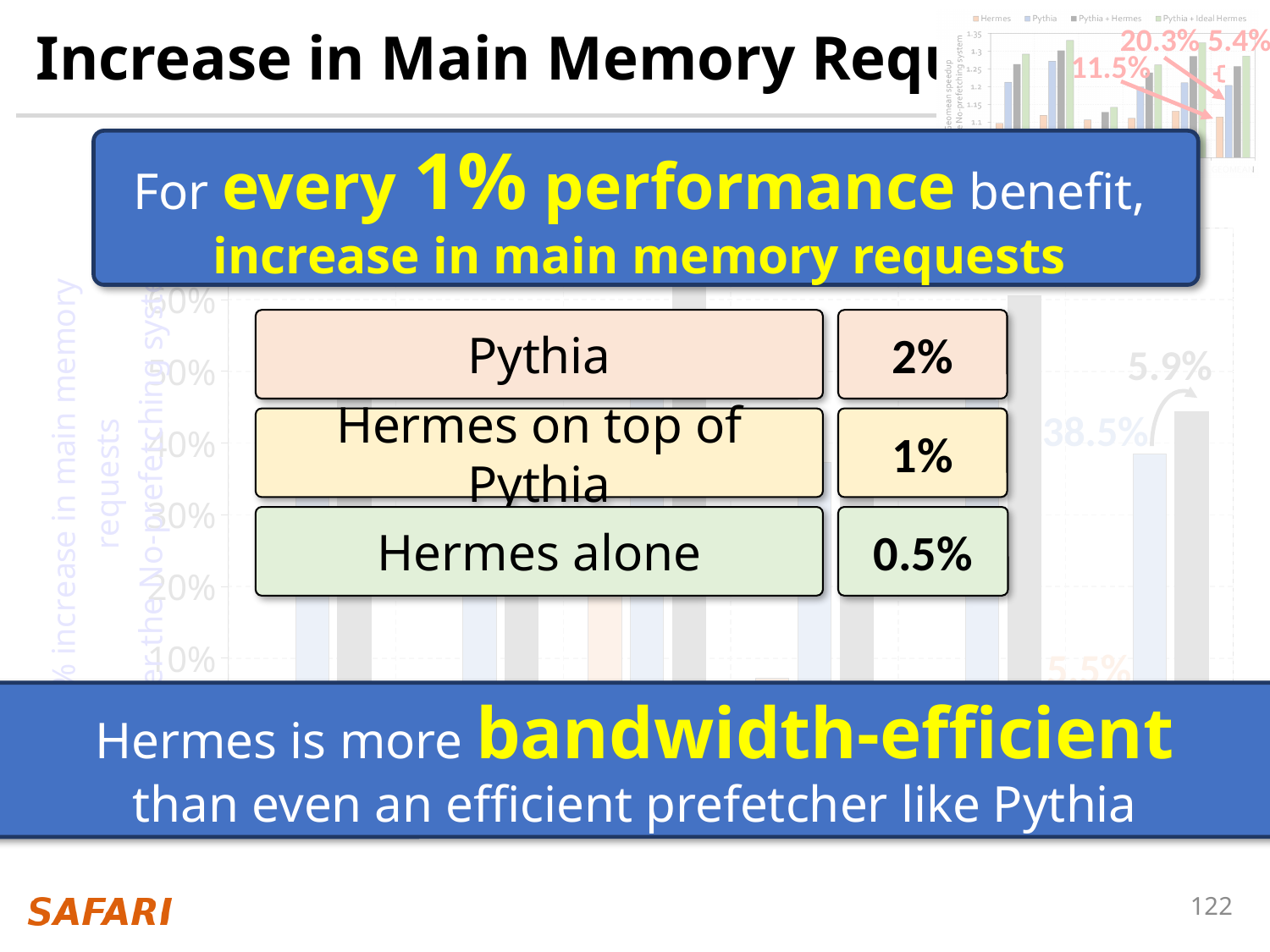
According to the boxes overlaid on the chart, what is the increase in main memory requests per 1% performance benefit for Pythia? 2% On the large background chart, what is the lowest y-axis tick label shown? 10% On the large background chart, which is larger, the value labeled 38.5% or the value labeled 5.5%? 38.5% How many series does the legend of the small inset chart in the top-right corner list? 4 What kind of chart is the large faded chart in the background of the slide? bar chart On the small inset chart in the top-right corner, what is the highest y-axis tick label shown? 1.35 What are the legend entries of the small inset chart in the top-right corner? Hermes, Pythia, Pythia + Hermes, Pythia + Ideal Hermes According to the boxes overlaid on the chart, what is the increase in main memory requests per 1% performance benefit for Hermes alone? 0.5% On the small inset chart in the top-right corner, what is the lowest y-axis tick label shown? 1.1 On the large background chart, is the bar labeled 38.5% greater or less than 30%? greater What kind of chart is the small inset chart in the top-right corner of the slide? bar chart According to the boxes overlaid on the chart, which has the lowest increase in main memory requests per 1% performance benefit: Pythia, Hermes on top of Pythia, or Hermes alone? Hermes alone